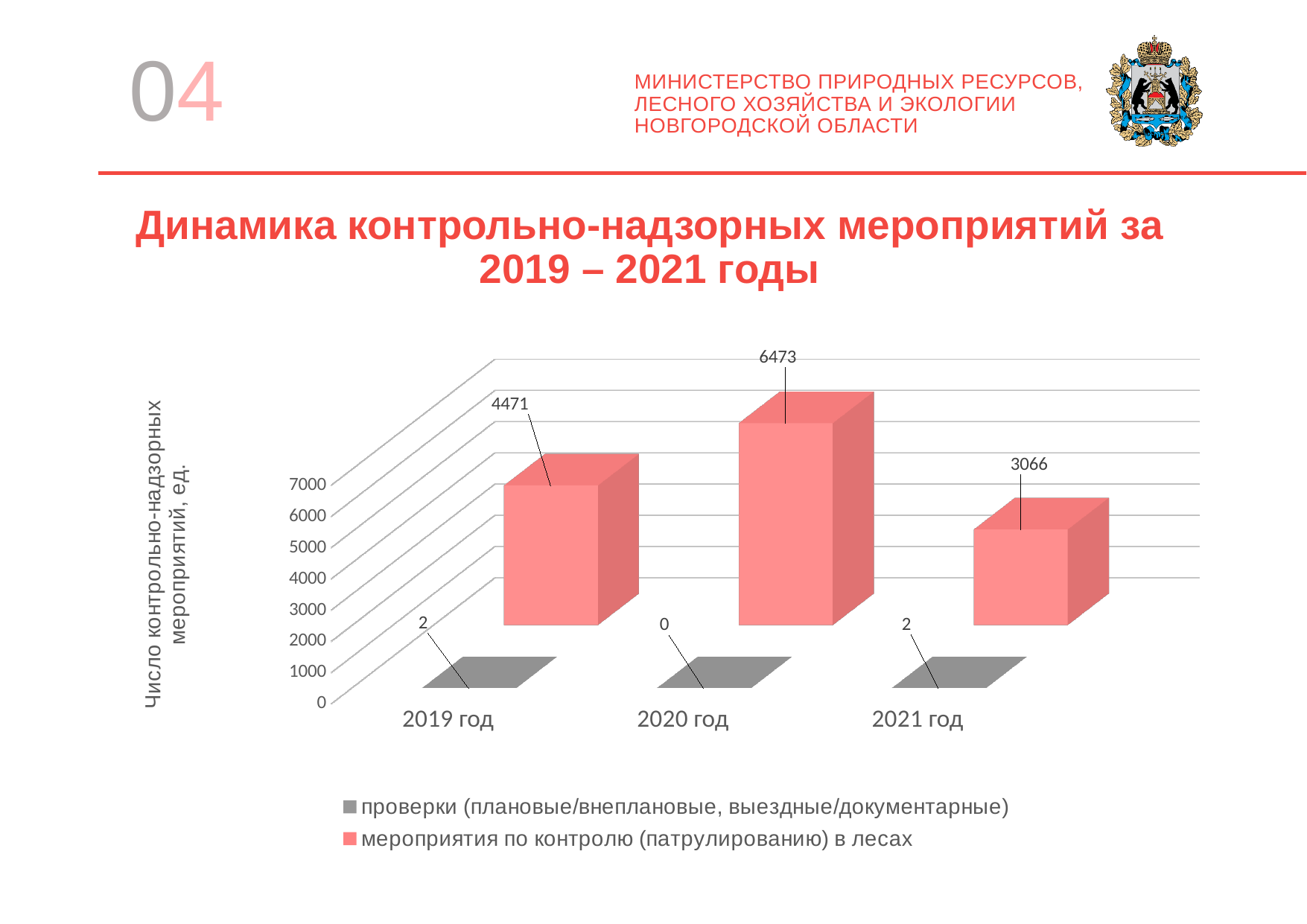
What is the value for 'проверки (плановые/внеплановые, выездные/документарные)' in 2019 год? 2 How many years are shown on the x axis? 3 What is the value for 'мероприятия по контролю (патрулированию) в лесах' in 2019 год? 4471 What is the difference between the 'мероприятия по контролю (патрулированию) в лесах' values for 2020 год and 2021 год? 3407 What kind of chart is shown on the slide? Bar chart How many series does the legend list? 2 What is the value for 'проверки (плановые/внеплановые, выездные/документарные)' in 2020 год? 0 In which year is the value for 'мероприятия по контролю (патрулированию) в лесах' highest? 2020 год In which year is the value for 'мероприятия по контролю (патрулированию) в лесах' lowest? 2021 год What is the value for 'мероприятия по контролю (патрулированию) в лесах' in 2020 год? 6473 Which is larger for 'мероприятия по контролю (патрулированию) в лесах': 2019 год or 2021 год? 2019 год What is the value for 'мероприятия по контролю (патрулированию) в лесах' in 2021 год? 3066